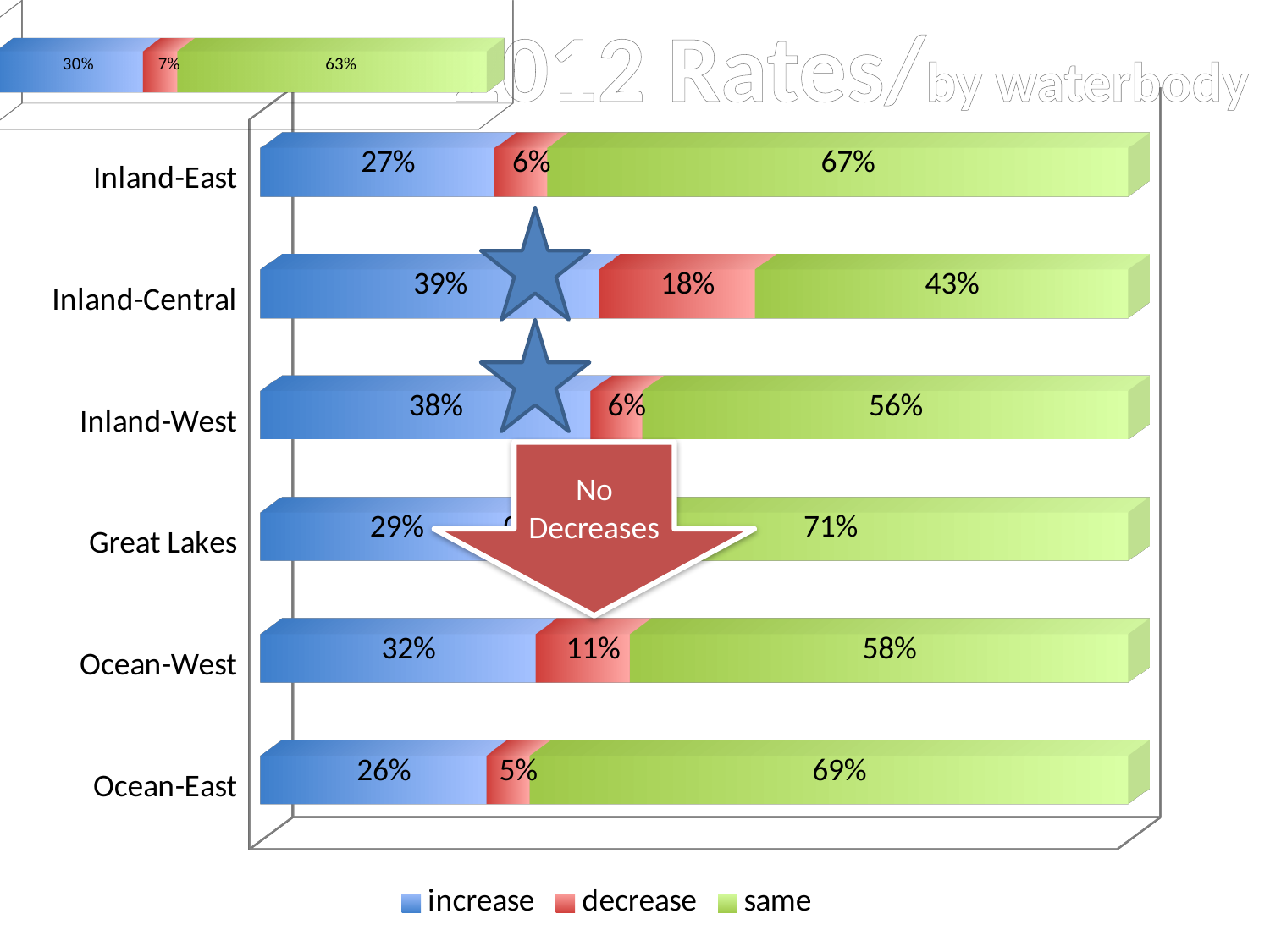
In the main chart '2012 Rates/by waterbody', what colour represents the 'decrease' series? Red In the main chart '2012 Rates/by waterbody', which waterbody has the highest 'decrease' value? Inland-Central In the small chart at the top-left of the slide, what is the value of the green 'same' segment? 63% In the main chart '2012 Rates/by waterbody', which is larger: the 'increase' value for Ocean-West or for Ocean-East? Ocean-West How many waterbody categories are shown in the main chart '2012 Rates/by waterbody'? 6 In the main chart '2012 Rates/by waterbody', what is the 'same' value for Great Lakes? 71% In the main chart '2012 Rates/by waterbody', what is the 'increase' value for Inland-Central? 39% How many series does the legend of the main chart '2012 Rates/by waterbody' list? 3 In the main chart '2012 Rates/by waterbody', what is the 'decrease' value for Ocean-West? 11% In the main chart '2012 Rates/by waterbody', what is the difference between the 'same' values for Inland-East and Ocean-East? 2% What kind of chart is the main chart '2012 Rates/by waterbody'? Stacked bar chart In the main chart '2012 Rates/by waterbody', which waterbody has the lowest 'same' value? Inland-Central